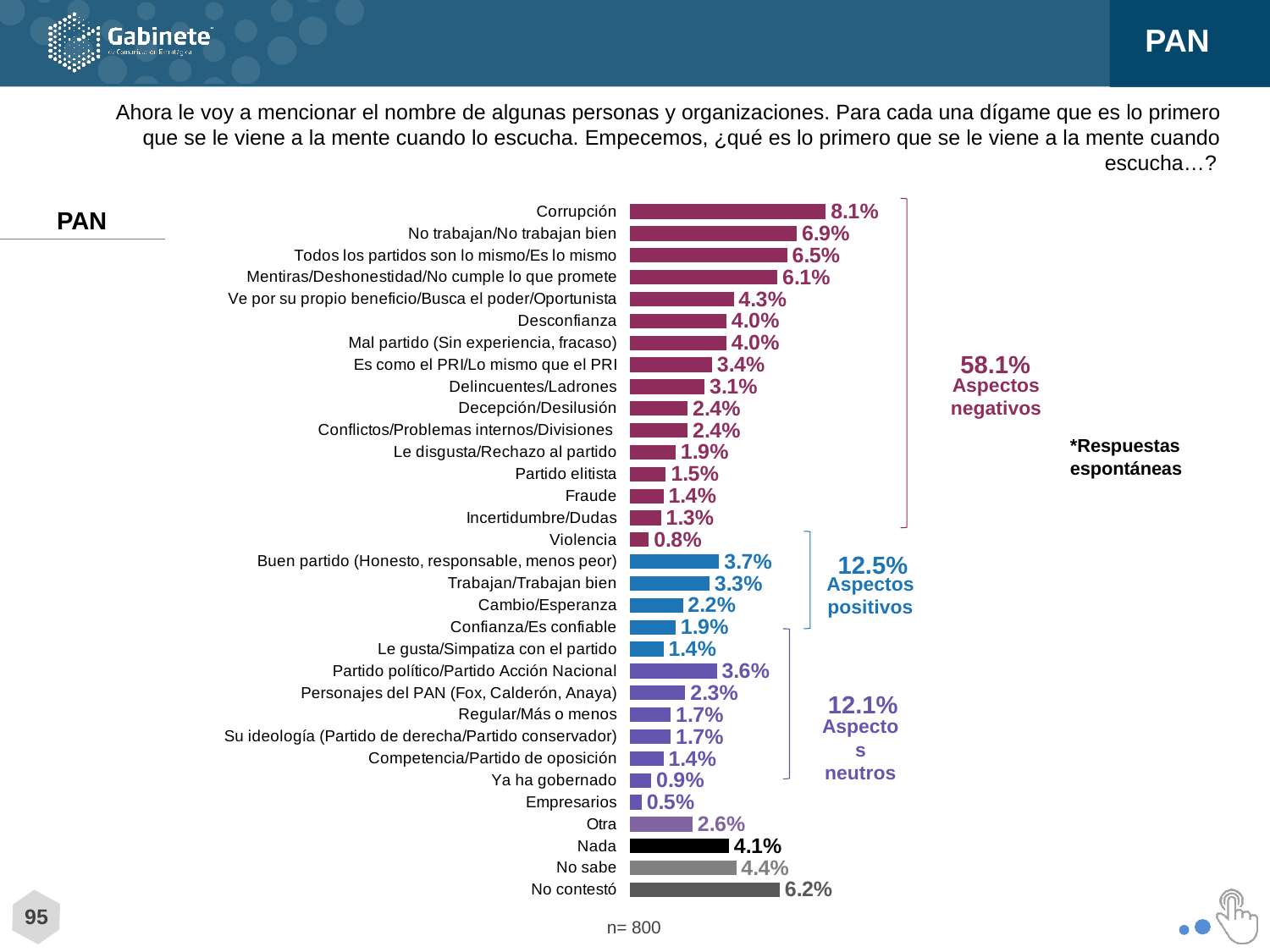
What total percentage is given for "Aspectos negativos"? 58.1% Which category has the lowest value in the chart? Empresarios What is the difference between the values for "Corrupción" and "No trabajan/No trabajan bien"? 1.2% What percentage of respondents mentioned "Corrupción" when hearing PAN? 8.1% How many categories are plotted in the chart? 32 Which is larger, the value for "No sabe" or the value for "Nada"? No sabe What is the value for "Partido político/Partido Acción Nacional"? 3.6% What sample size (n) is indicated below the chart? n= 800 Which category has the highest value in the chart? Corrupción What is the value shown for "No contestó"? 6.2% What percentage is shown for "Buen partido (Honesto, responsable, menos peor)"? 3.7% What type of chart is shown on the slide? Bar chart